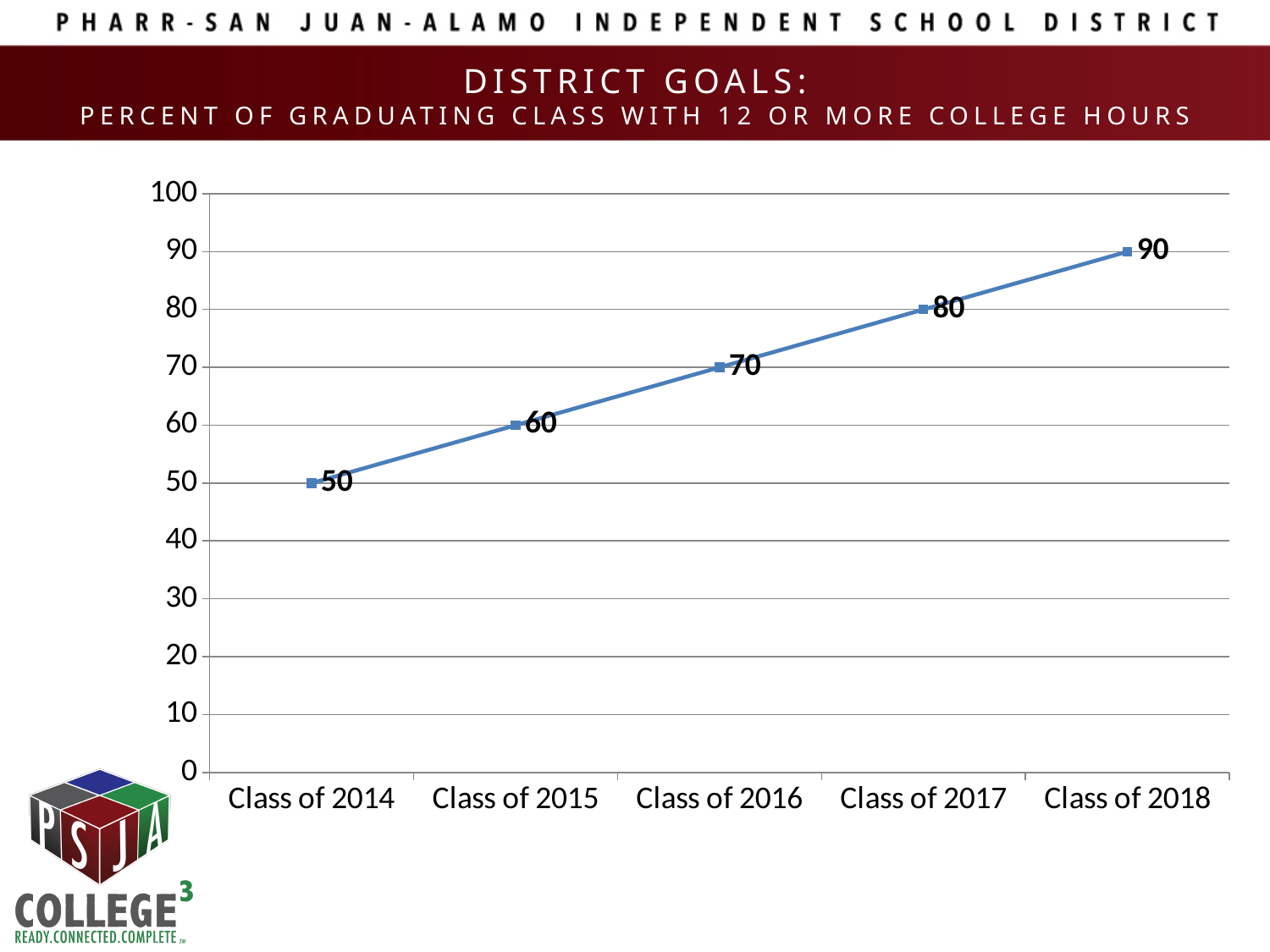
What is the value for Class of 2018? 90 How many classes are plotted on the chart? 5 What is the difference between the values for Class of 2017 and Class of 2015? 20 What is the value for Class of 2016? 70 What kind of chart is shown on the slide? Line chart Which is larger, the value for Class of 2015 or the value for Class of 2017? Class of 2017 What is the difference between the values for Class of 2018 and Class of 2014? 40 What is the value for Class of 2014? 50 Which class has the lowest value? Class of 2014 Which class has the highest value? Class of 2018 What is the title of the chart? District Goals: Percent of Graduating Class with 12 or More College Hours Do the values rise or fall from Class of 2014 to Class of 2018? Rise